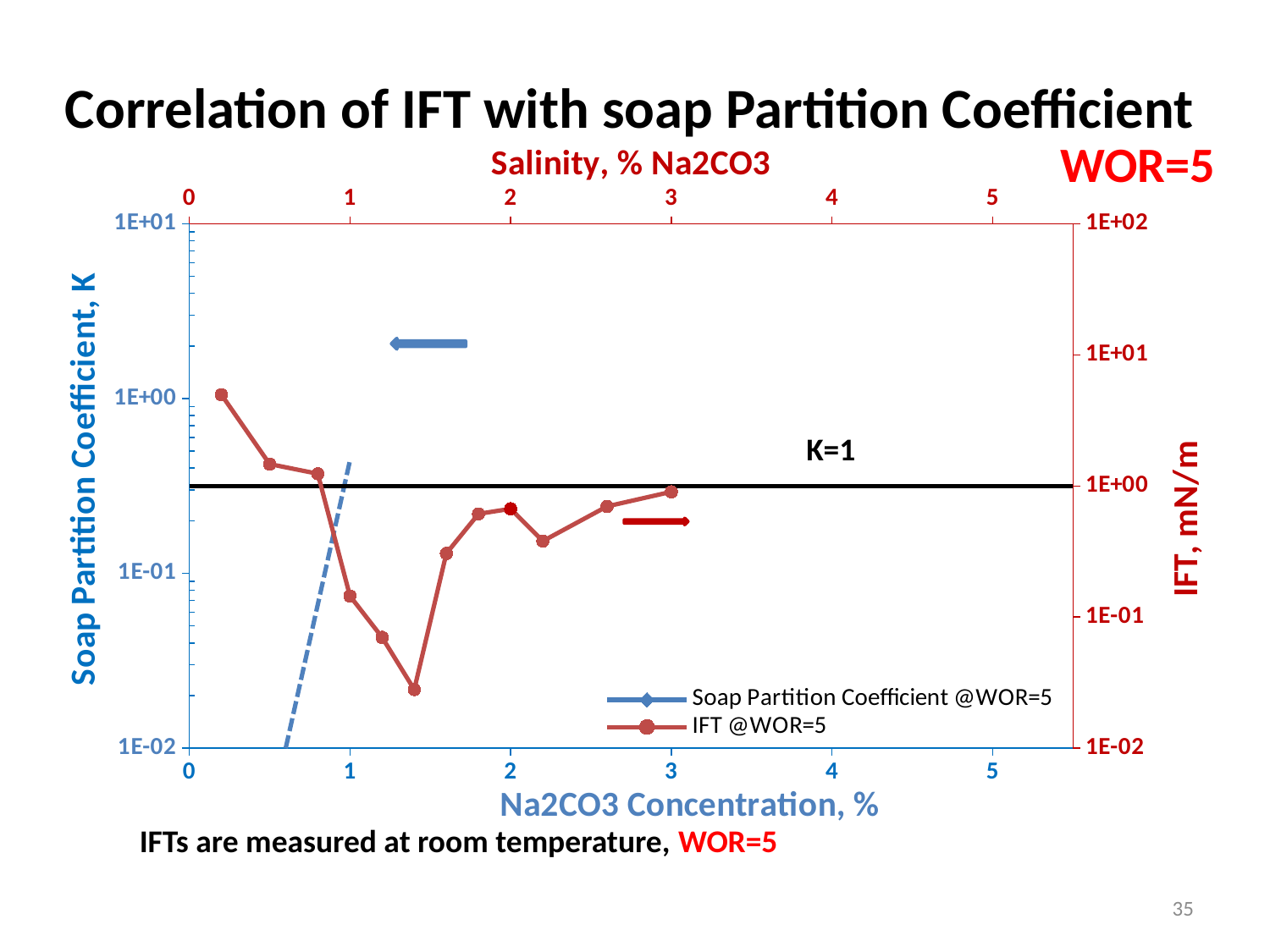
How many data points are plotted for the IFT @WOR=5 series? 12 What are the two series named in the legend? Soap Partition Coefficient @WOR=5 and IFT @WOR=5 How does the IFT @WOR=5 series change as Na2CO3 concentration increases from 0.2% to 1.4%? It falls How does the IFT @WOR=5 series change as Na2CO3 concentration increases from 1.4% to 3%? It rises Is the IFT value at 1.4% Na2CO3 greater or less than 1E-01 mN/m? less How many series does the legend list? 2 What is the title of the chart? Correlation of IFT with soap Partition Coefficient What kind of chart is shown on the slide? line chart Is the IFT value at 0.2% Na2CO3 greater or less than 1E+00 mN/m? greater Which has the higher IFT: 0.2% Na2CO3 or 3% Na2CO3? 0.2% Na2CO3